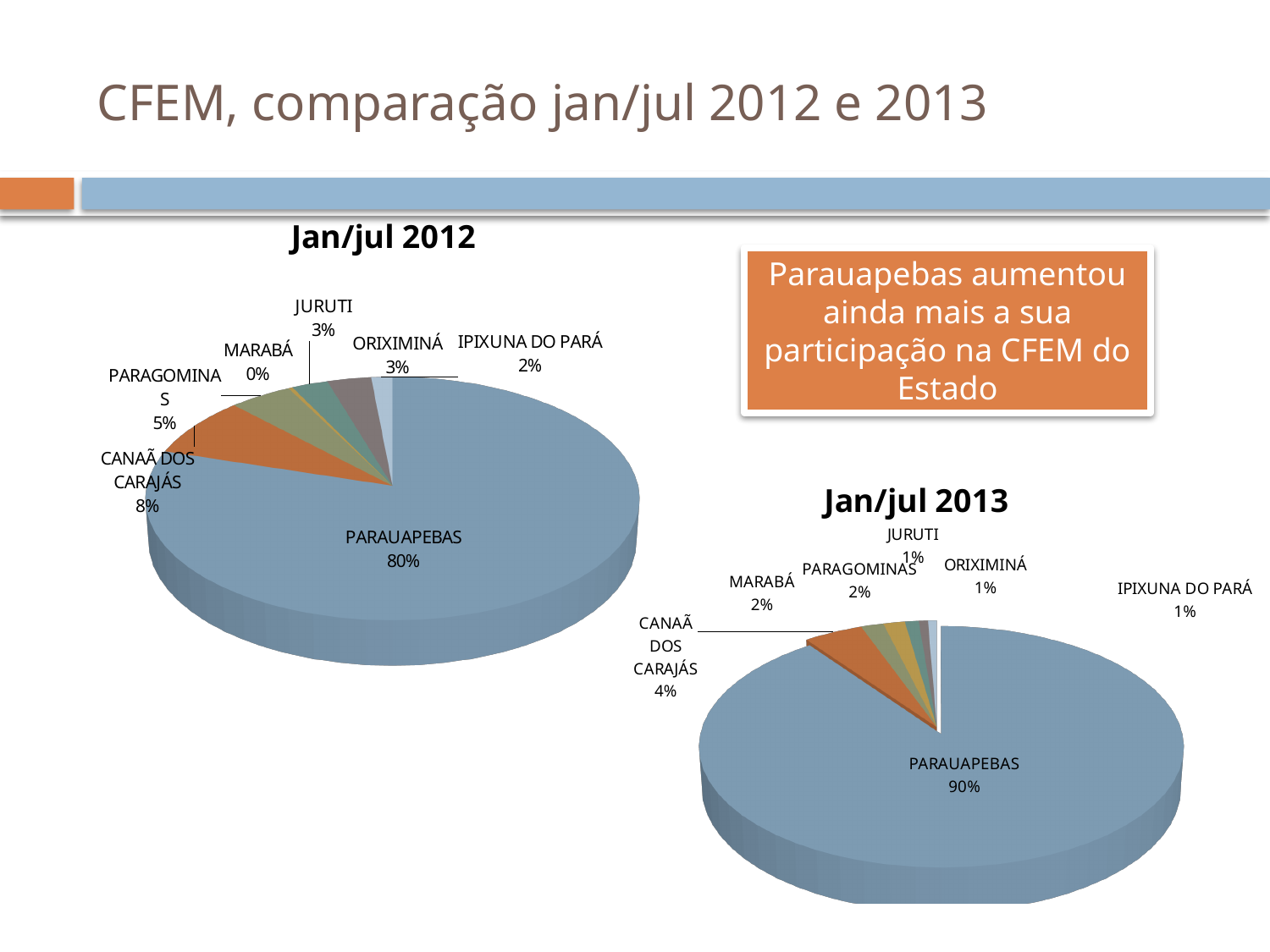
In the Jan/jul 2012 chart, which category has the smallest share? MARABÁ In the Jan/jul 2013 chart, what share does PARAUAPEBAS have? 90% In the Jan/jul 2012 chart, which category has the largest share? PARAUAPEBAS In the Jan/jul 2012 chart, what is the value for PARAGOMINAS? 5% In the Jan/jul 2012 chart, what share does PARAUAPEBAS have? 80% In the Jan/jul 2013 chart, what is the value for MARABÁ? 2% What is the difference between the PARAUAPEBAS share in the Jan/jul 2013 chart and in the Jan/jul 2012 chart? 10% In the Jan/jul 2012 chart, what is the value for MARABÁ? 0% What type of chart is the Jan/jul 2012 chart? Pie chart In the Jan/jul 2012 chart, what is the value for CANAÃ DOS CARAJÁS? 8% How many categories are shown in the Jan/jul 2013 chart? 7 In the Jan/jul 2013 chart, what is the value for CANAÃ DOS CARAJÁS? 4%